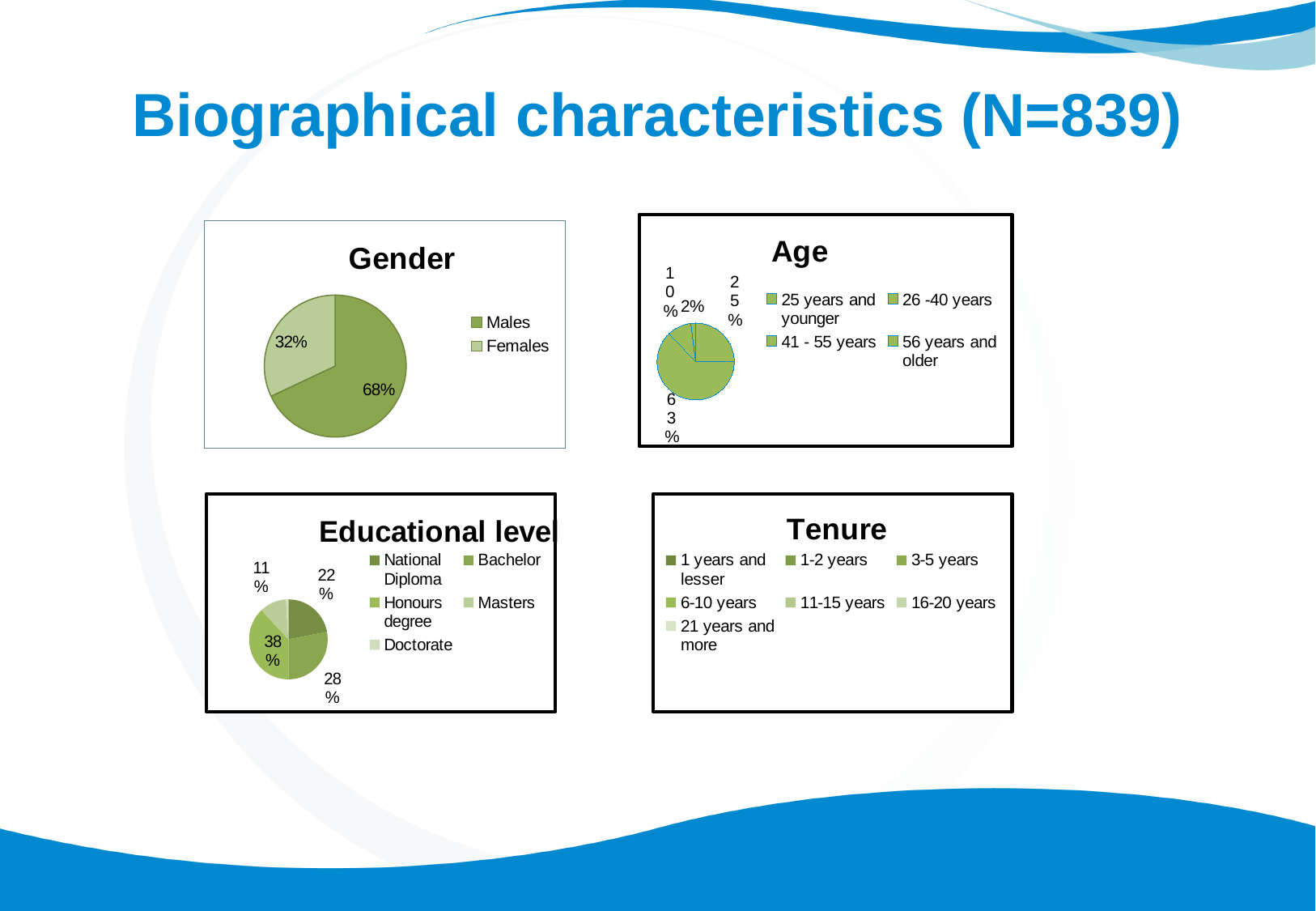
On the Age chart, what is the smallest percentage label shown on the pie? 2% On the Gender chart, what percentage is shown for Males? 68% How many categories does the Gender chart's legend list? 2 On the Gender chart, which category has the larger share? Males On the Educational level chart, what is the largest percentage label shown on the pie? 38% How many categories does the Tenure chart's legend list? 7 What kind of chart is the Gender chart? Pie chart On the Gender chart, what is the difference between the Males and Females percentages? 36% How many categories does the Age chart's legend list? 4 On the Age chart, what is the largest percentage label shown on the pie? 63% On the Gender chart, what percentage is shown for Females? 32%